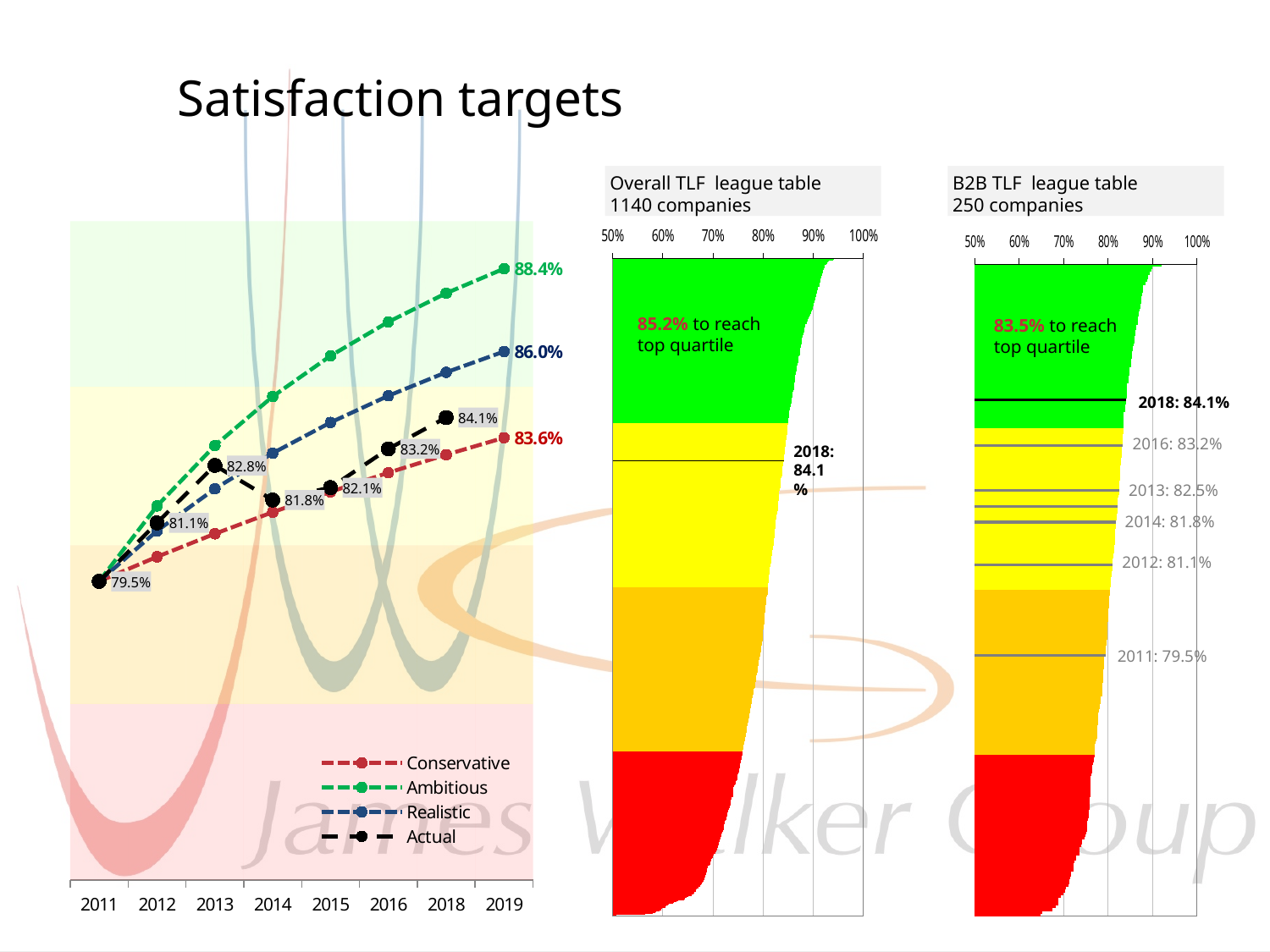
In the line chart on the left, what is the Actual value for 2011? 79.5% In the line chart on the left, what value does the Ambitious series reach in 2019? 88.4% In the line chart on the left, how many years are labelled on the x axis? 8 In the line chart on the left, how many series does the legend list? 4 In the line chart on the left, what value does the Conservative series reach in 2019? 83.6% In the Overall TLF league table chart, what score is needed to reach the top quartile? 85.2% In the line chart on the left, is the Actual value for 2014 higher or lower than the Actual value for 2013? lower In the line chart on the left, what is the difference between the Actual values for 2018 and 2011? 4.6% In the line chart on the left, what value does the Realistic series reach in 2019? 86.0% In the line chart on the left, which series has the highest value in 2019? Ambitious In the line chart on the left, what is the Actual value for 2018? 84.1% In the B2B TLF league table chart, what is the value shown for 2013? 82.5%